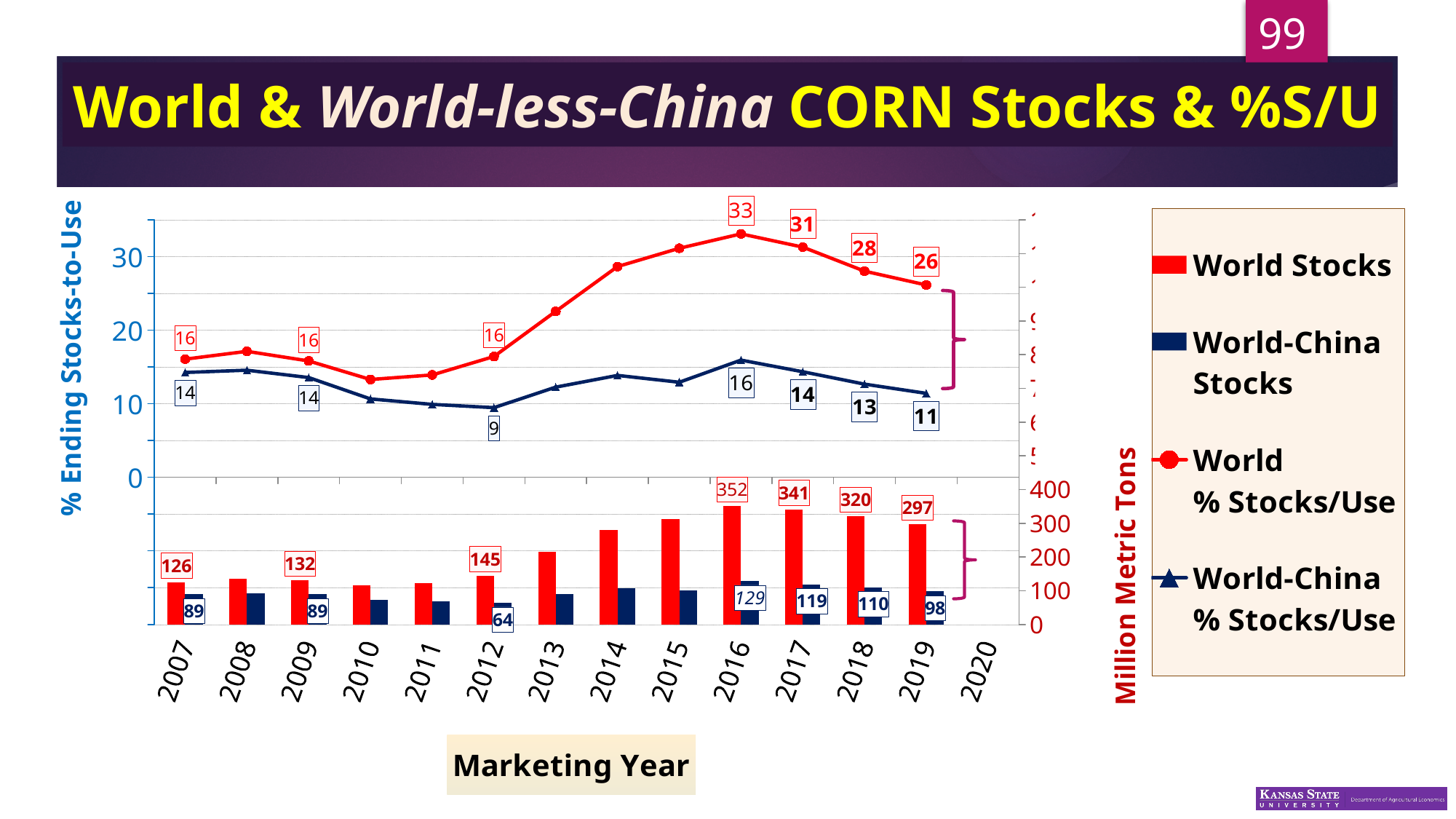
In which marketing year are World Stocks highest? 2016 What is the World Stocks value for 2016? 352 How much higher are World Stocks in 2016 than in 2019? 55 What is the World-China % Stocks/Use value for 2018? 13 What is the difference between World Stocks and World-China Stocks in 2017? 222 Which year has larger World-China Stocks, 2016 or 2019? 2016 Is the World Stocks value for 2014 greater or less than 200? greater In which marketing year is World-China % Stocks/Use lowest? 2012 Does World % Stocks/Use rise or fall from 2016 to 2019? fall What is the World % Stocks/Use value for 2019? 26 How many series does the legend list? 4 What is the World-China Stocks value for 2012? 64